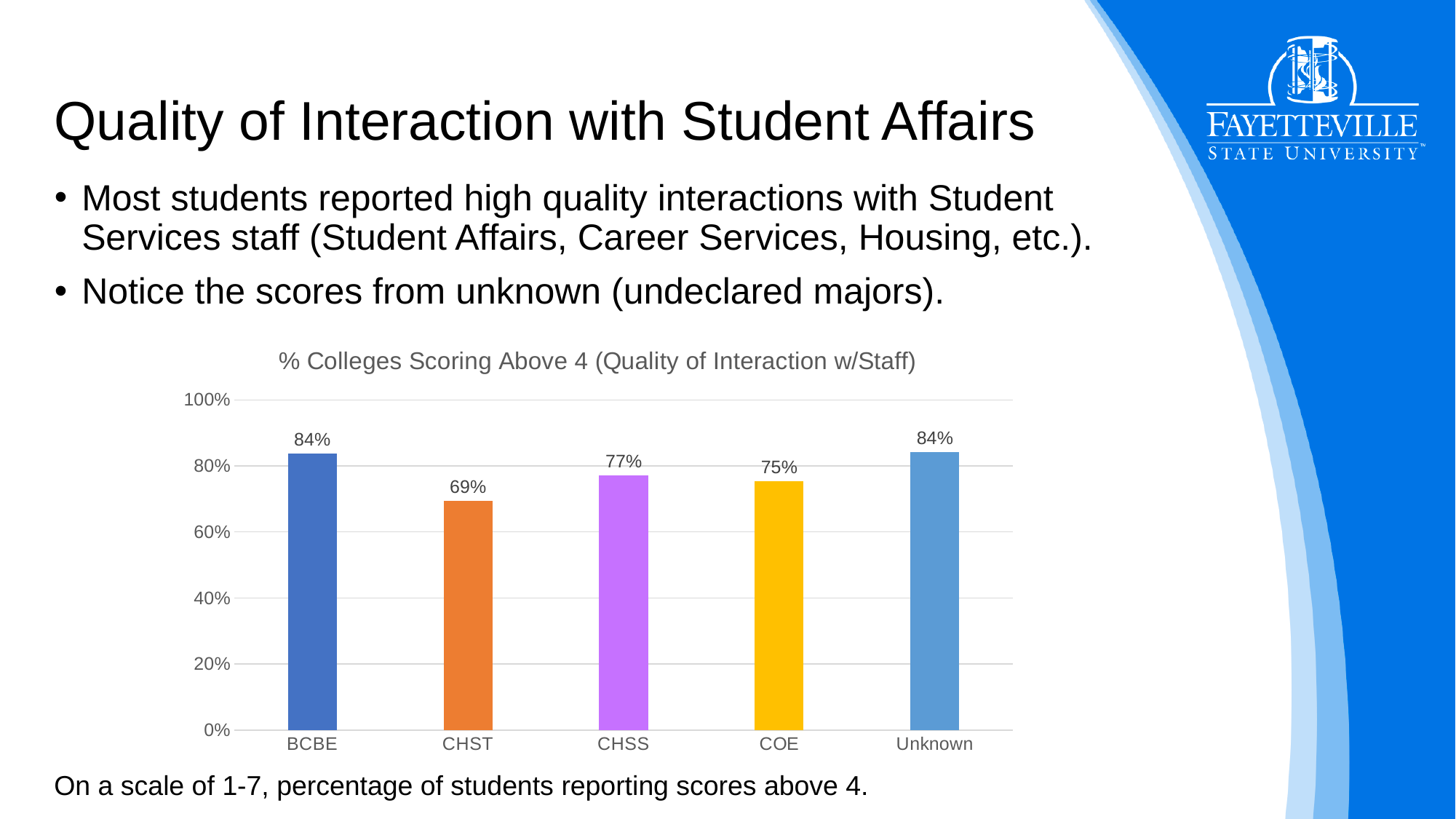
Is the value for COE greater or less than 80%? less What is the title of the chart? % Colleges Scoring Above 4 (Quality of Interaction w/Staff) What is the value for Unknown? 84% What is the value for COE? 75% Which is larger, the value for CHSS or the value for CHST? CHSS What is the value for CHST? 69% How many categories are shown on the x axis? 5 What is the value for CHSS? 77% What is the difference between the values for CHSS and COE? 2% What kind of chart is shown on the slide? bar chart Which category has the lowest value? CHST What is the difference between the values for BCBE and CHST? 15%